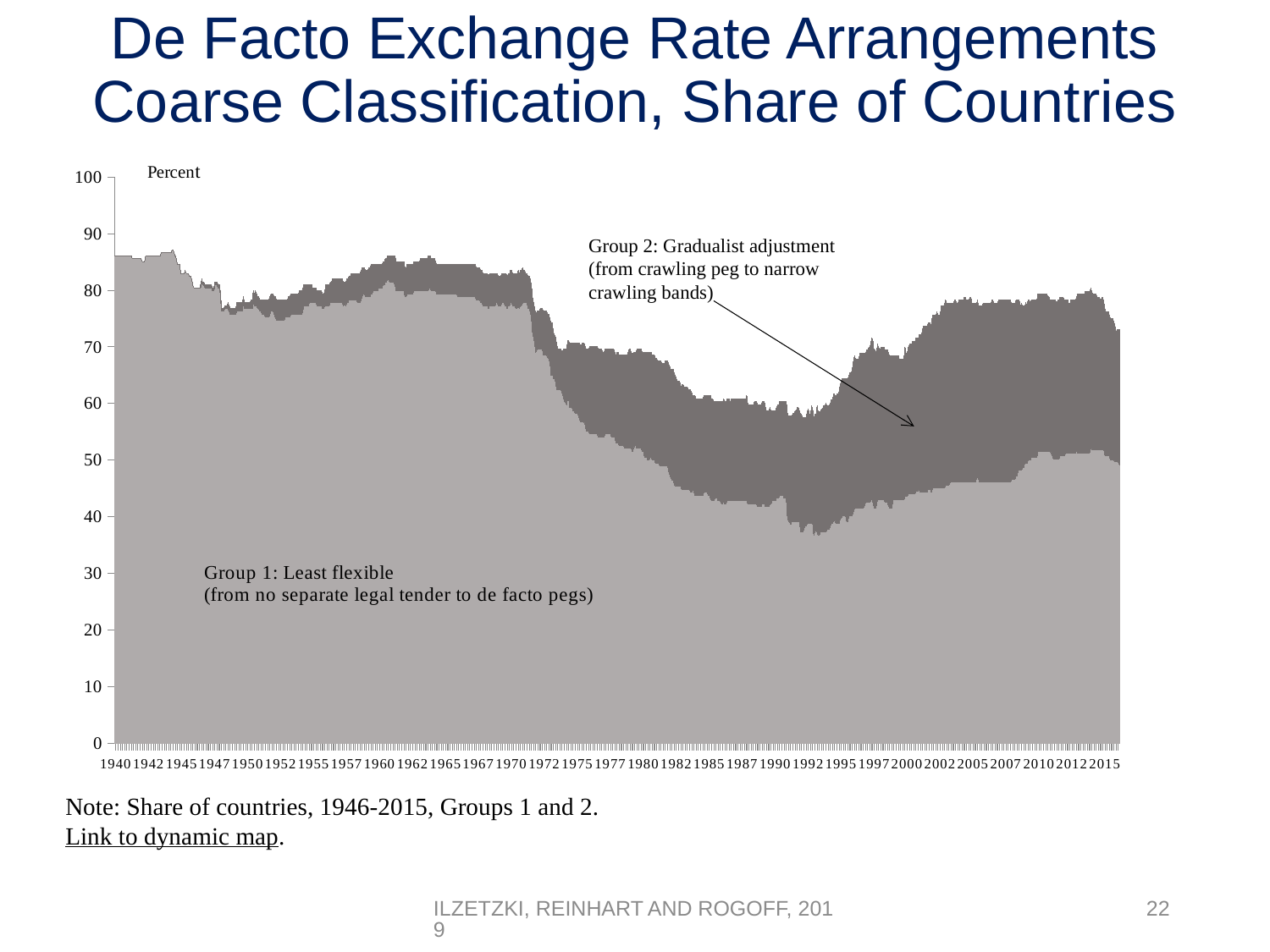
Is the share for Group 1 around 1992 greater or less than 40? less How many groups (series) are plotted in the chart? 2 What kind of chart is shown on the slide? Stacked area chart Which group is shown in the lighter gray shade at the bottom of the chart? Group 1: Least flexible Is the share for Group 1 in 1940 greater or less than 80? greater Does the share for Group 1 rise or fall between 1940 and 1992? fall Does the share for Group 1 rise or fall between 1992 and 2012? rise Is the share for Group 1 around 1985 greater or less than 50? less What is the label on the vertical axis of the chart? Percent In 2015, which group has the larger share, Group 1 or Group 2? Group 1